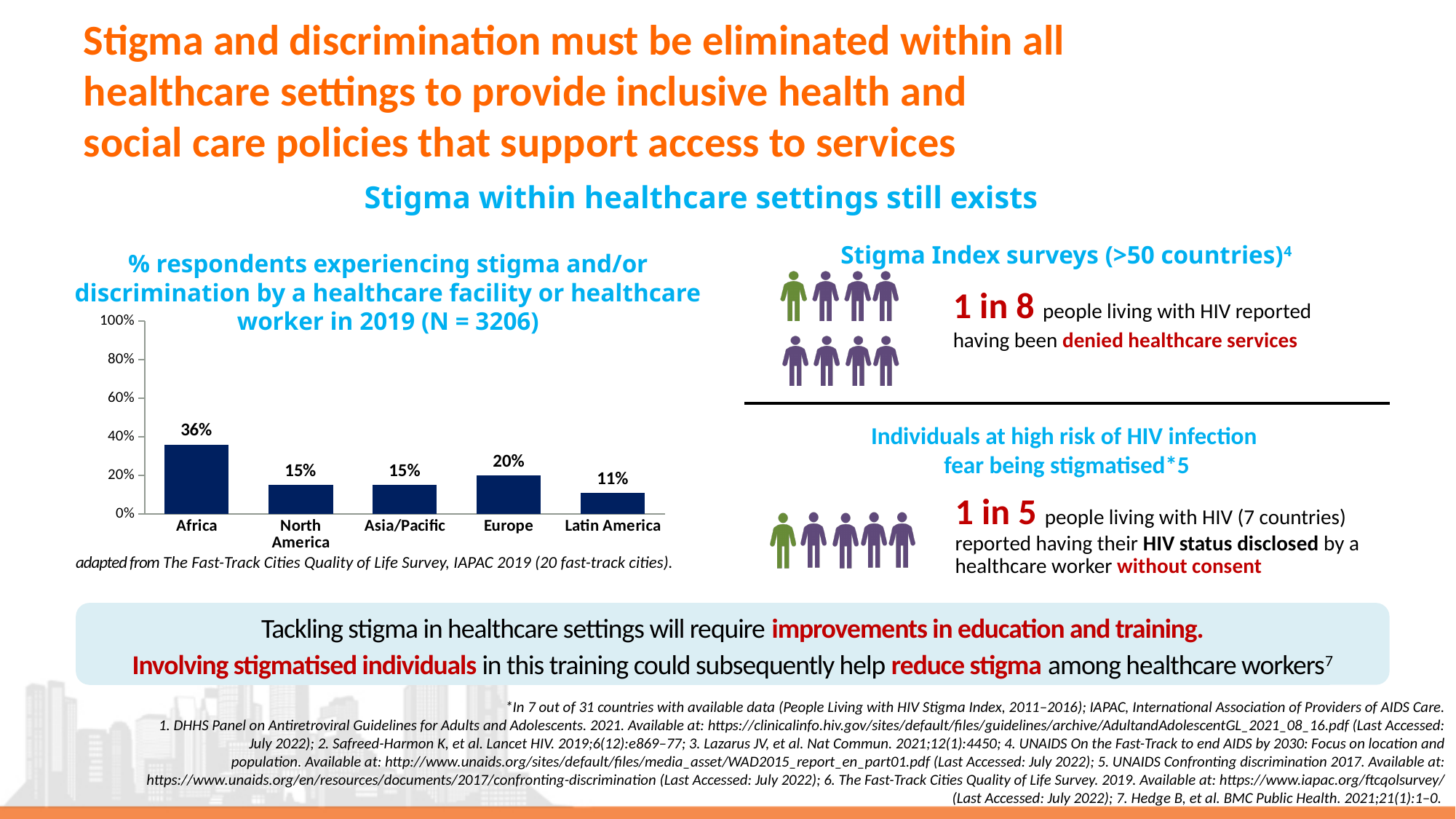
What is the sample size (N) stated in the bar chart title? 3206 Which region has the highest percentage of respondents experiencing stigma and/or discrimination? Africa What is the value shown for Europe in the bar chart? 20% How many regions are shown in the bar chart? 5 What is the difference in percentage points between Africa and Europe in the bar chart? 16% What percentage of respondents in Africa experienced stigma and/or discrimination by a healthcare facility or healthcare worker in 2019? 36% What type of chart is used to show the % of respondents experiencing stigma and/or discrimination? Bar chart Which region has the lowest percentage of respondents experiencing stigma and/or discrimination? Latin America Is the value for Africa greater or less than 40%? less What is the difference between the values for Europe and Latin America? 9% Which has a higher value in the bar chart, Europe or North America? Europe What is the value shown for Latin America in the bar chart? 11%